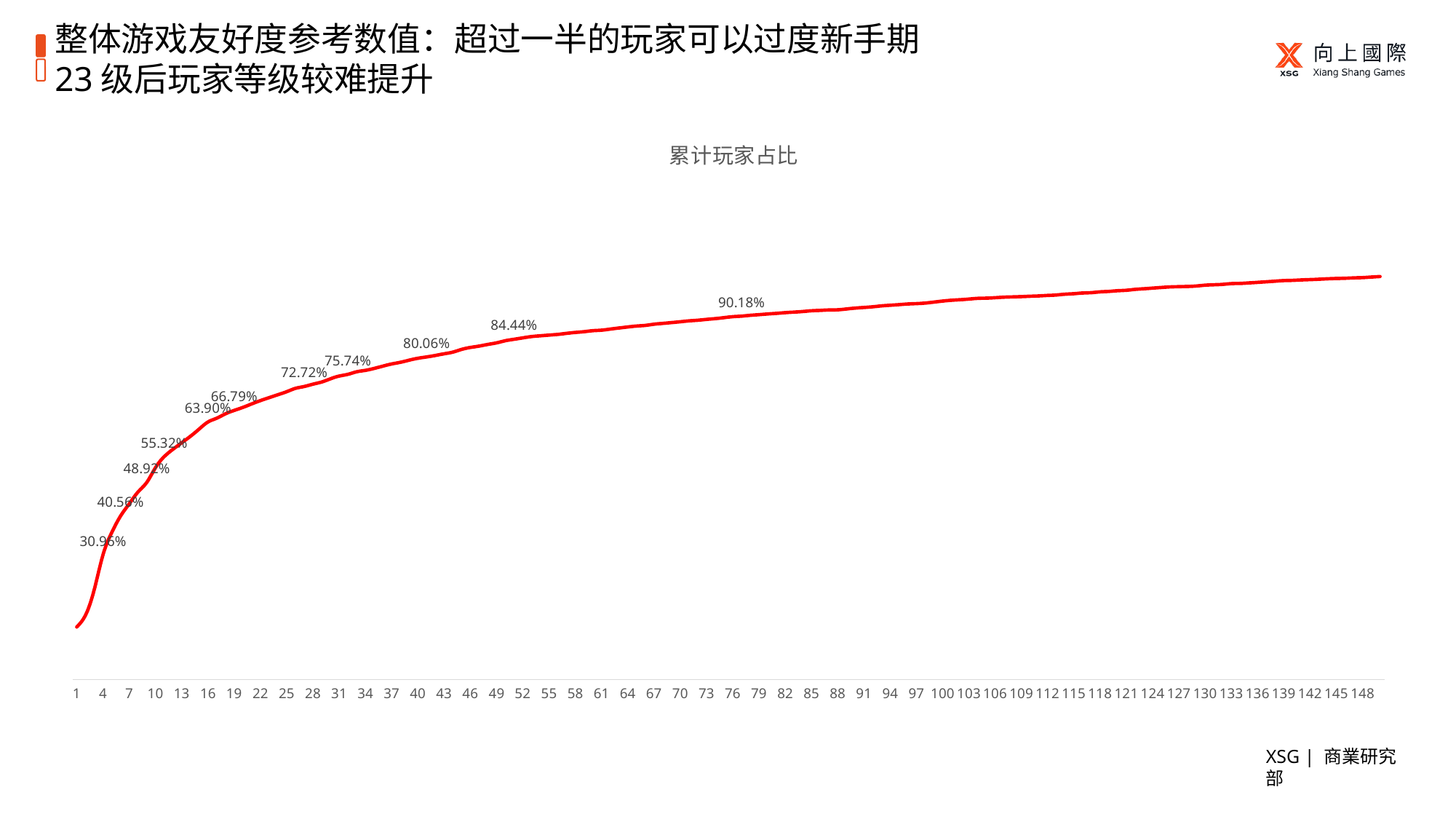
What is the title of the chart? 累计玩家占比 What kind of chart is shown on the slide? line chart How many lines (series) are plotted on the chart? 1 What is the first label on the x axis? 1 What is the lowest data label printed on the line? 30.96% Does the cumulative player share rise or fall as the level increases along the x axis? rise What is the difference between the data labels 84.44% and 80.06%? 4.38% What is the last label on the x axis? 148 What is the highest data label printed on the line? 90.18% What is the difference between the highest printed data label (90.18%) and the lowest printed data label (30.96%)? 59.22% Which printed data label is larger, 63.90% or 66.79%? 66.79% How many data labels are printed on the line? 11